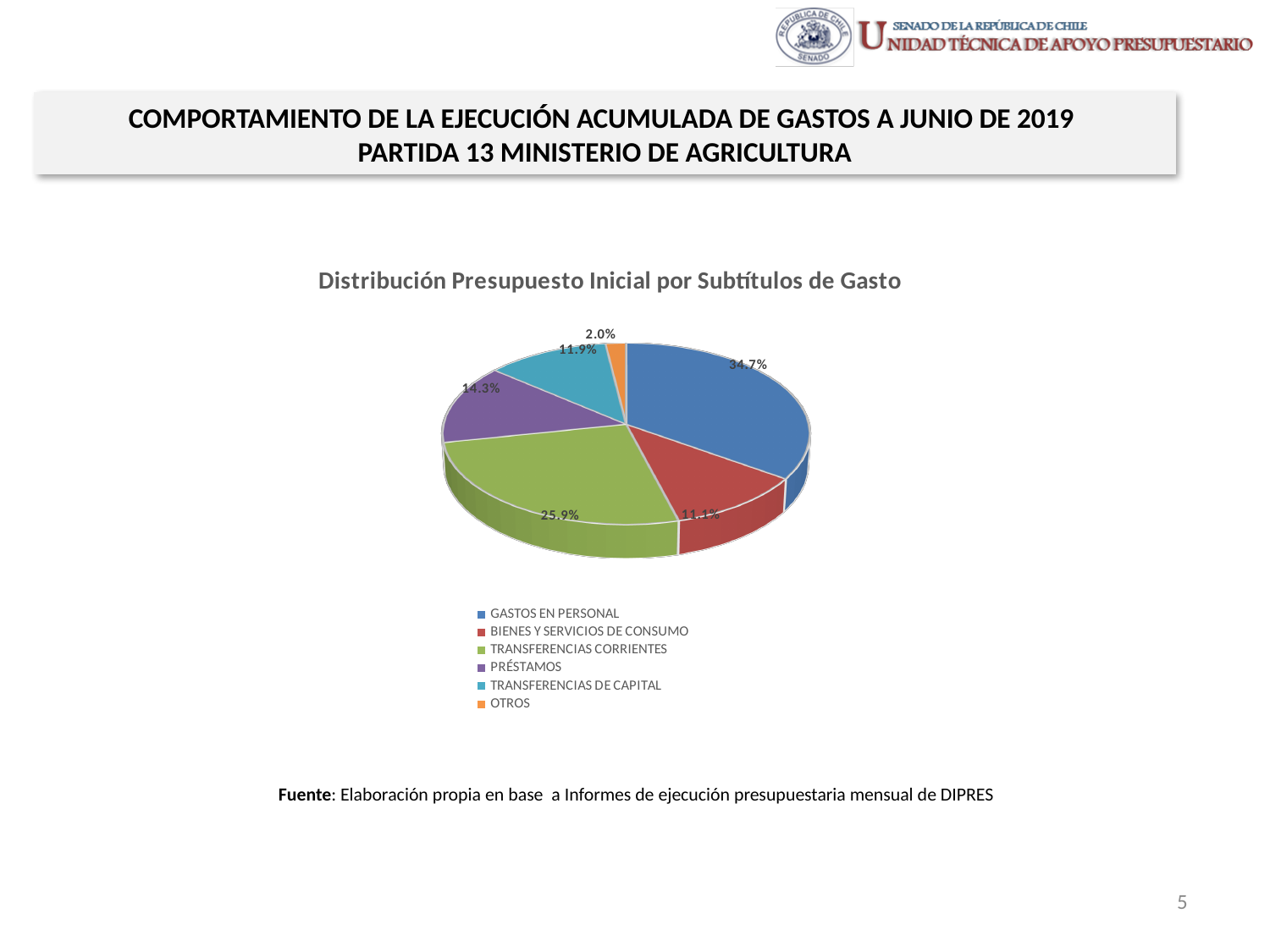
What share of the pie does GASTOS EN PERSONAL represent? 34.7% Which is larger, the share for PRÉSTAMOS or the share for TRANSFERENCIAS DE CAPITAL? PRÉSTAMOS What share of the pie does PRÉSTAMOS represent? 14.3% What type of chart is shown on the slide? Pie chart Which category has the largest share of the pie? GASTOS EN PERSONAL How many categories does the legend list? 6 Which category has the smallest share of the pie? OTROS What share of the pie does TRANSFERENCIAS CORRIENTES represent? 25.9% What is the title of the chart? Distribución Presupuesto Inicial por Subtítulos de Gasto What is the difference in percentage points between GASTOS EN PERSONAL and TRANSFERENCIAS CORRIENTES? 8.8